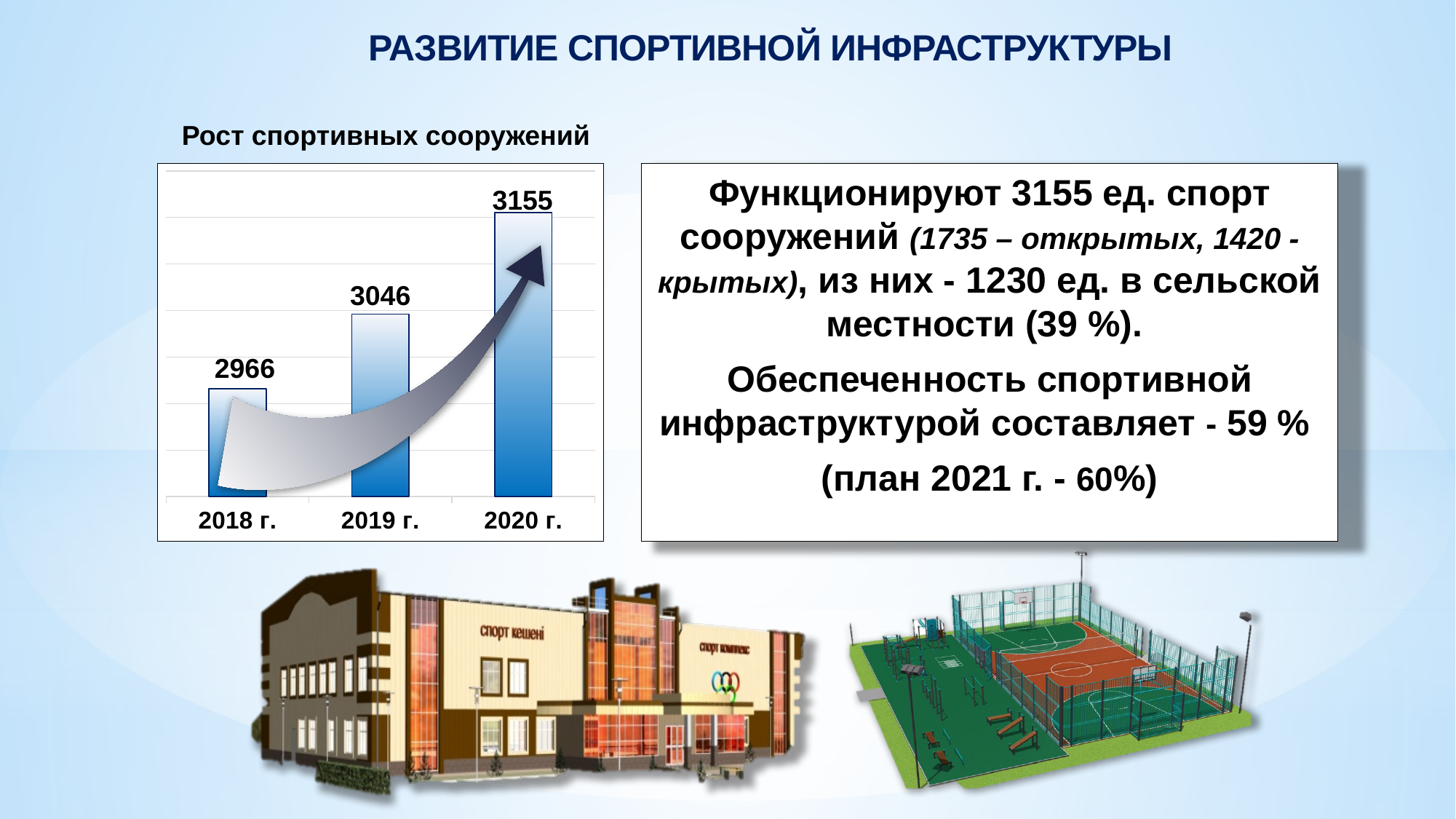
In the chart 'Рост спортивных сооружений', which is larger: the value for 2019 г. or the value for 2018 г.? 2019 г. Do the values in the chart 'Рост спортивных сооружений' rise or fall from 2018 г. to 2020 г.? rise How many years (categories) are shown in the chart 'Рост спортивных сооружений'? 3 What is the value for 2020 г. in the chart 'Рост спортивных сооружений'? 3155 Which year has the lowest value in the chart 'Рост спортивных сооружений'? 2018 г. What is the value for 2019 г. in the chart 'Рост спортивных сооружений'? 3046 What is the value for 2018 г. in the chart 'Рост спортивных сооружений'? 2966 Which year has the highest value in the chart 'Рост спортивных сооружений'? 2020 г. What is the difference between the values for 2020 г. and 2018 г. in the chart 'Рост спортивных сооружений'? 189 What is the difference between the values for 2020 г. and 2019 г. in the chart 'Рост спортивных сооружений'? 109 What kind of chart is 'Рост спортивных сооружений'? bar chart What is the difference between the values for 2019 г. and 2018 г. in the chart 'Рост спортивных сооружений'? 80